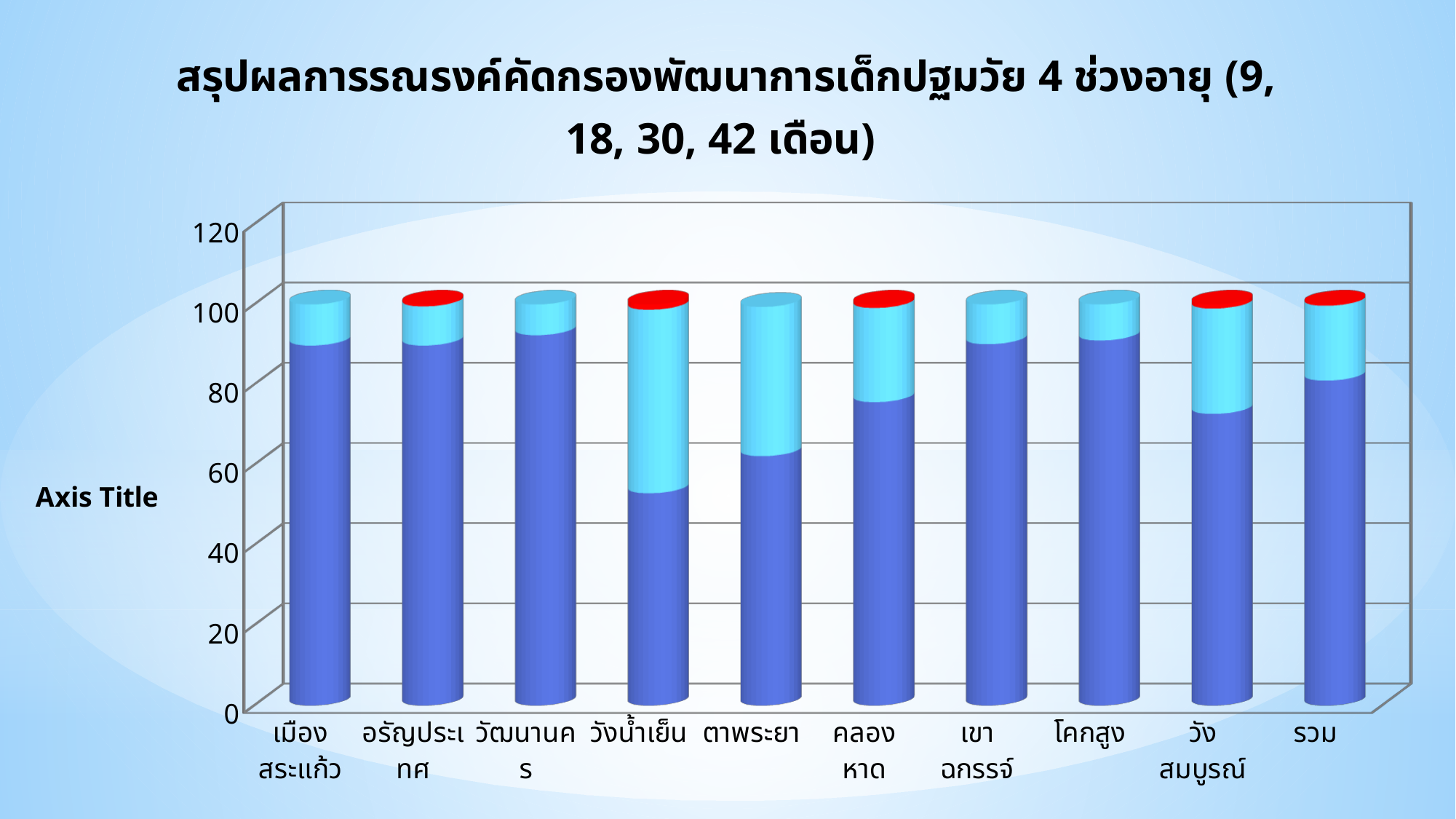
Is the total height of the bar for รวม greater or less than 80? greater Which category has the smallest dark blue segment? วังน้ำเย็น Is the dark blue segment for วังน้ำเย็น greater or less than 60? less Which has the larger dark blue segment, โคกสูง or ตาพระยา? โคกสูง What kind of chart is shown on the slide? Stacked bar chart Which has the larger dark blue segment, เมืองสระแก้ว or วังน้ำเย็น? เมืองสระแก้ว What is the title of the chart? สรุปผลการรณรงค์คัดกรองพัฒนาการเด็กปฐมวัย 4 ช่วงอายุ (9, 18, 30, 42 เดือน) Is the dark blue segment for เมืองสระแก้ว greater or less than 80? greater How many categories are shown along the x axis of the chart? 10 What is the title of the vertical axis on the chart? Axis Title